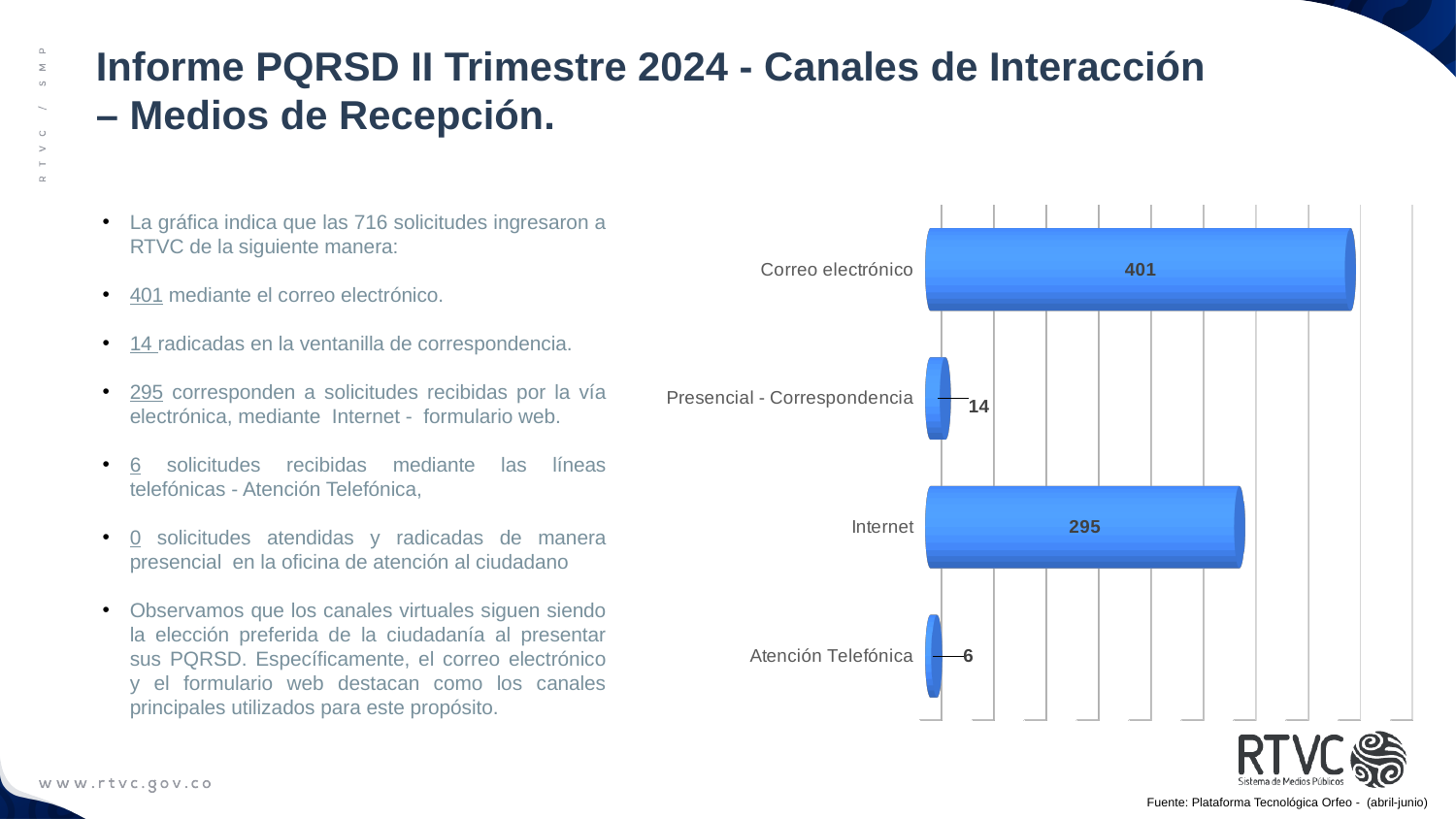
What is the value for Correo electrónico? 401 Which category has the highest value? Correo electrónico What kind of chart is shown on the slide? Bar chart What is the total of all four values shown in the chart? 716 What is the value for Presencial - Correspondencia? 14 What is the value for Atención Telefónica? 6 How many categories are shown in the chart? 4 Which is larger, the value for Internet or the value for Presencial - Correspondencia? Internet What is the difference between the values for Correo electrónico and Internet? 106 What is the value for Internet? 295 Which category has the lowest value? Atención Telefónica What is the difference between the values for Presencial - Correspondencia and Atención Telefónica? 8